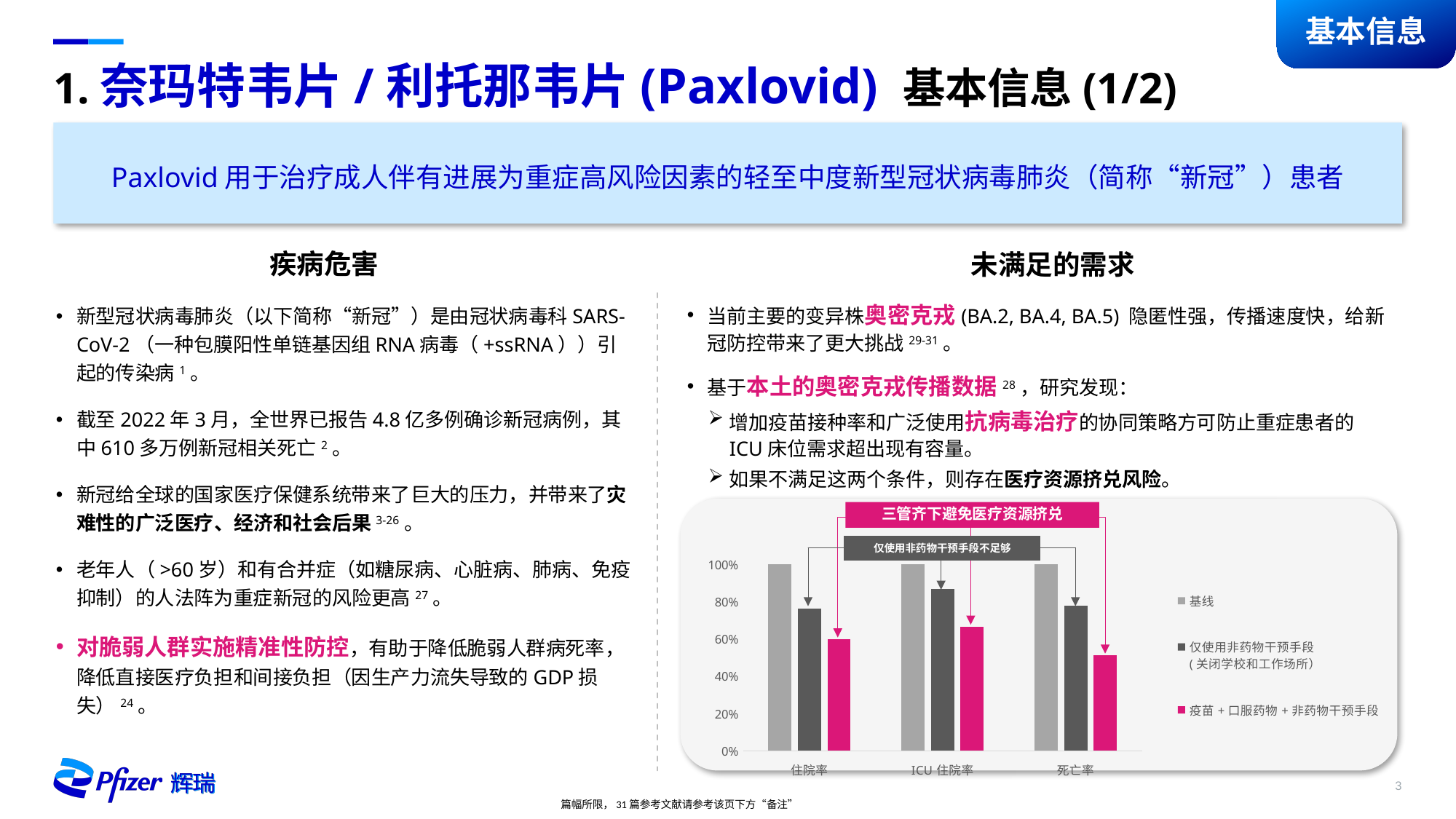
Is the value of the 仅使用非药物干预手段 bar for ICU 住院率 greater or less than 80%? greater What text is in the pink box above the chart? 三管齐下避免医疗资源挤兑 How many categories are shown on the x axis of the chart? 3 For 死亡率, which series has the lowest bar? 疫苗 + 口服药物 + 非药物干预手段 For ICU 住院率, which is larger: the 仅使用非药物干预手段 bar or the 疫苗 + 口服药物 + 非药物干预手段 bar? 仅使用非药物干预手段 Is the value of the 疫苗 + 口服药物 + 非药物干预手段 bar for 死亡率 greater or less than 60%? less What kind of chart is shown on the slide? bar chart What is the value of the 基线 bar for 住院率? 100% Is the value of the 疫苗 + 口服药物 + 非药物干预手段 bar for ICU 住院率 greater or less than 80%? less How many series does the chart legend list? 3 What is the value of the 基线 bar for 死亡率? 100%